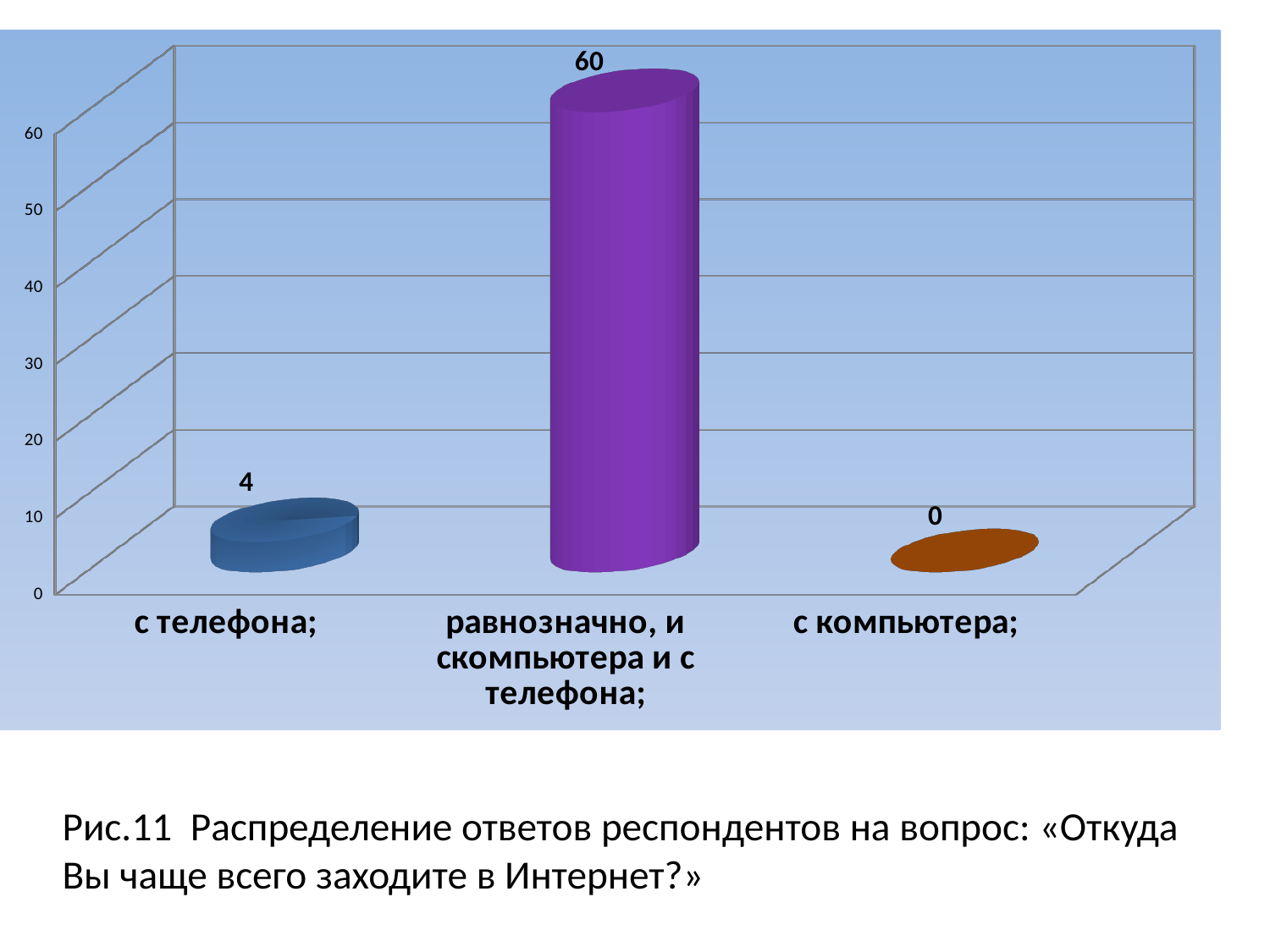
What is the value for «равнозначно, и скомпьютера и с телефона;»? 60 What is the value for «с телефона;»? 4 What is the difference between the values for «равнозначно, и скомпьютера и с телефона;» and «с телефона;»? 56 How many categories are shown on the chart? 3 What is the figure number given in the caption below the chart? Рис.11 What kind of chart is shown on the slide? bar chart Which category has the highest value? равнозначно, и скомпьютера и с телефона; What is the total of all three values shown on the chart? 64 What is the value for «с компьютера;»? 0 Is the value for «равнозначно, и скомпьютера и с телефона;» greater or less than 50? greater Which is larger, the value for «с телефона;» or the value for «с компьютера;»? с телефона; Which category has the lowest value? с компьютера;